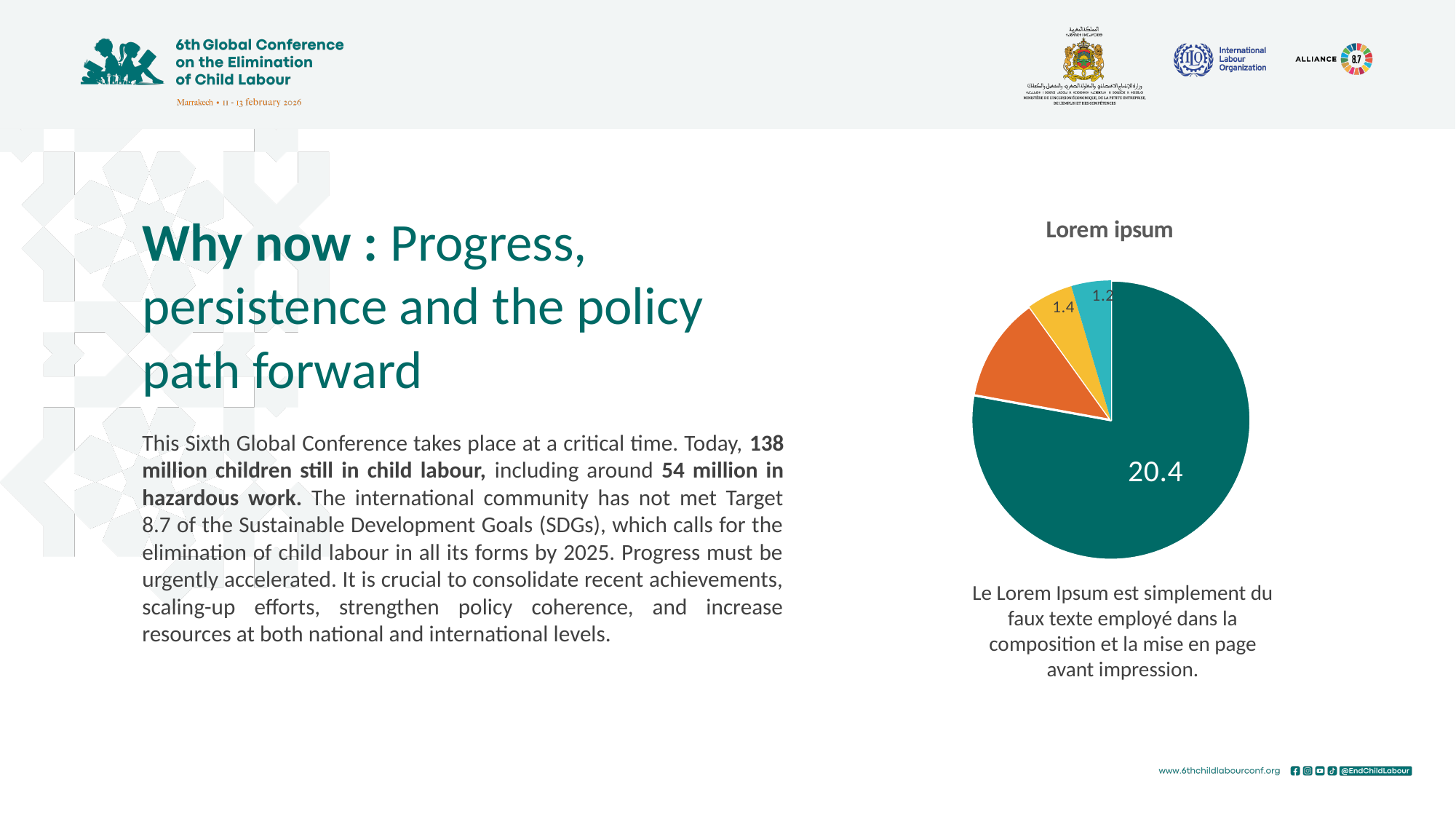
Which is larger in the pie chart, the dark teal slice or the orange slice? the dark teal slice Which slice of the pie chart is the smallest? the light teal slice (1.2) How many slices does the pie chart have? 4 What kind of chart is shown on the slide? pie chart What value is labelled on the largest (dark teal) slice of the pie chart? 20.4 What is the difference between the yellow slice (1.4) and the light teal slice (1.2)? 0.2 What is the title of the pie chart? Lorem ipsum Which is larger in the pie chart, the orange slice or the yellow slice? the orange slice Which slice of the pie chart is the largest? the dark teal slice (20.4) What value is labelled on the light teal slice of the pie chart? 1.2 What value is labelled on the yellow slice of the pie chart? 1.4 What is the difference between the dark teal slice (20.4) and the yellow slice (1.4)? 19.0